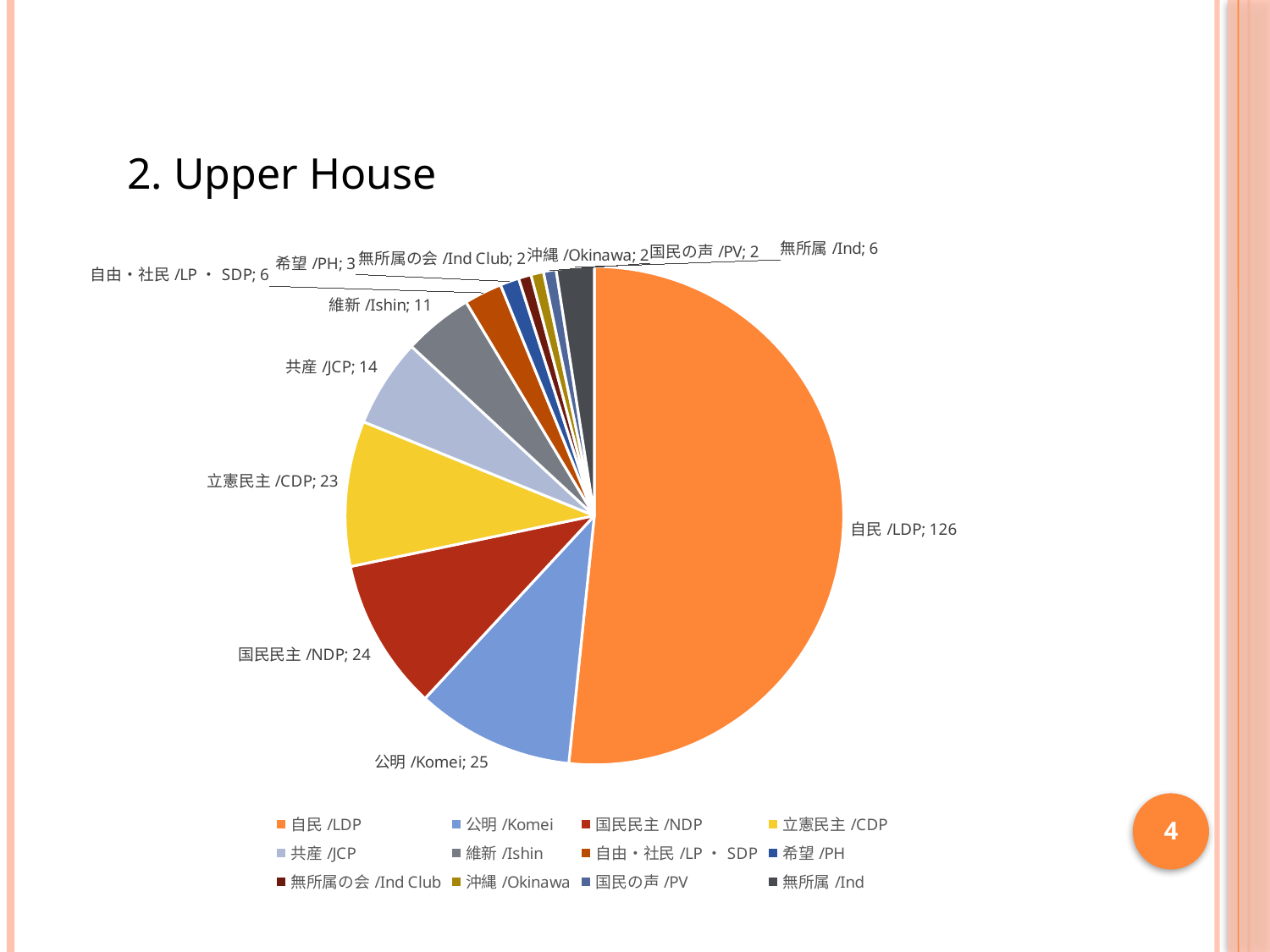
Which category has the largest slice of the pie? 自民 /LDP How many slices does the pie chart have? 12 What is the value for 自民 /LDP? 126 What is the value for 立憲民主 /CDP? 23 What is the value for 公明 /Komei? 25 Which is larger, the value for 公明 /Komei or the value for 国民民主 /NDP? 公明 /Komei What is the total of all the values shown in the pie chart? 244 How many entries does the legend list? 12 What kind of chart is shown on the slide? pie chart What is the title of the slide containing the chart? 2. Upper House What is the difference between the values for 国民民主 /NDP and 共産 /JCP? 10 What is the value for 維新 /Ishin? 11